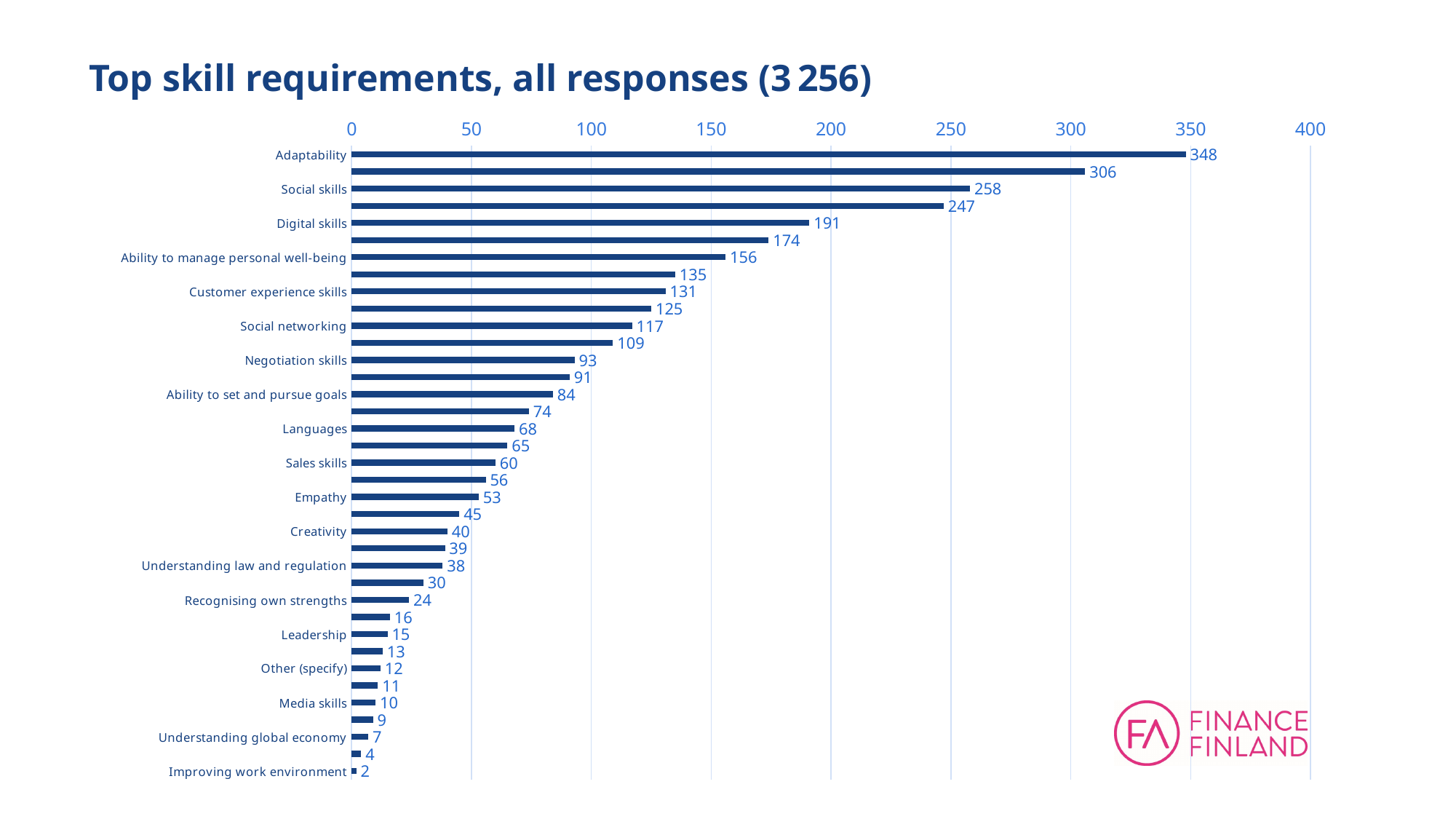
Which is larger, the value for Digital skills or the value for Customer experience skills? Digital skills What is the title of the chart? Top skill requirements, all responses (3 256) What is the value for Adaptability? 348 What is the difference between the values for Adaptability and Social skills? 90 What is the value for Understanding law and regulation? 38 What kind of chart is shown on the slide? bar chart What is the value for Negotiation skills? 93 Which category has the highest value? Adaptability Which category has the lowest value? Improving work environment Do the bar values rise or fall going from the top of the chart to the bottom? fall What is the value for Ability to manage personal well-being? 156 What is the value for Social skills? 258